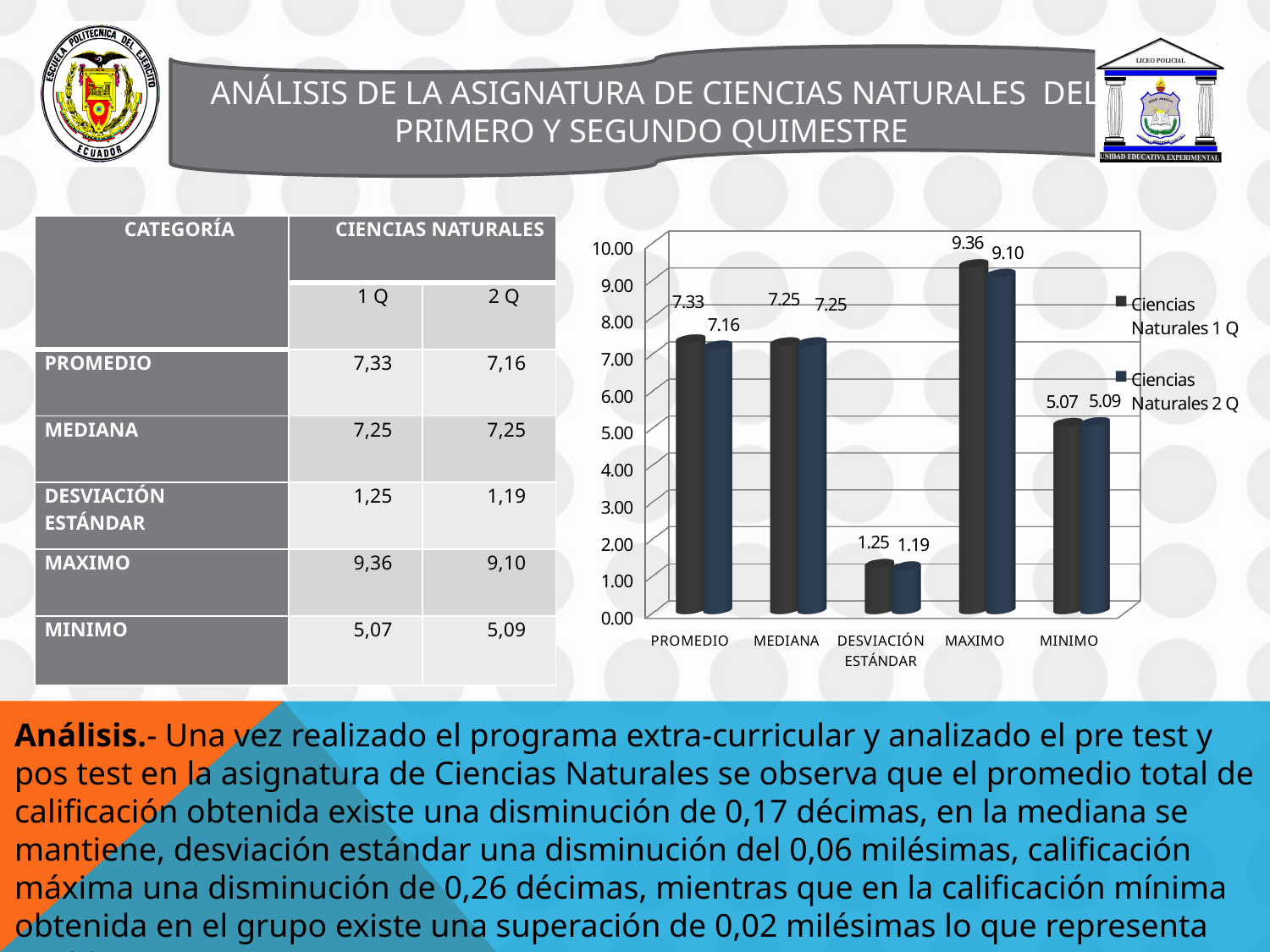
How many categories are shown on the x axis of the chart? 5 Which category has the lowest value in the Ciencias Naturales 2 Q series? DESVIACIÓN ESTÁNDAR What is the difference between the Ciencias Naturales 1 Q and Ciencias Naturales 2 Q values for MAXIMO? 0.26 What is the value for DESVIACIÓN ESTÁNDAR in the Ciencias Naturales 1 Q series? 1.25 What is the value for MINIMO in the Ciencias Naturales 2 Q series? 5.09 Which is larger for PROMEDIO: the Ciencias Naturales 1 Q value or the Ciencias Naturales 2 Q value? Ciencias Naturales 1 Q What is the difference between the Ciencias Naturales 2 Q and Ciencias Naturales 1 Q values for MINIMO? 0.02 What is the value for MAXIMO in the Ciencias Naturales 1 Q series? 9.36 What is the value for PROMEDIO in the Ciencias Naturales 2 Q series? 7.16 Which category has the highest value in the Ciencias Naturales 1 Q series? MAXIMO What kind of chart is shown on the slide? Bar chart How many series does the chart legend list? 2